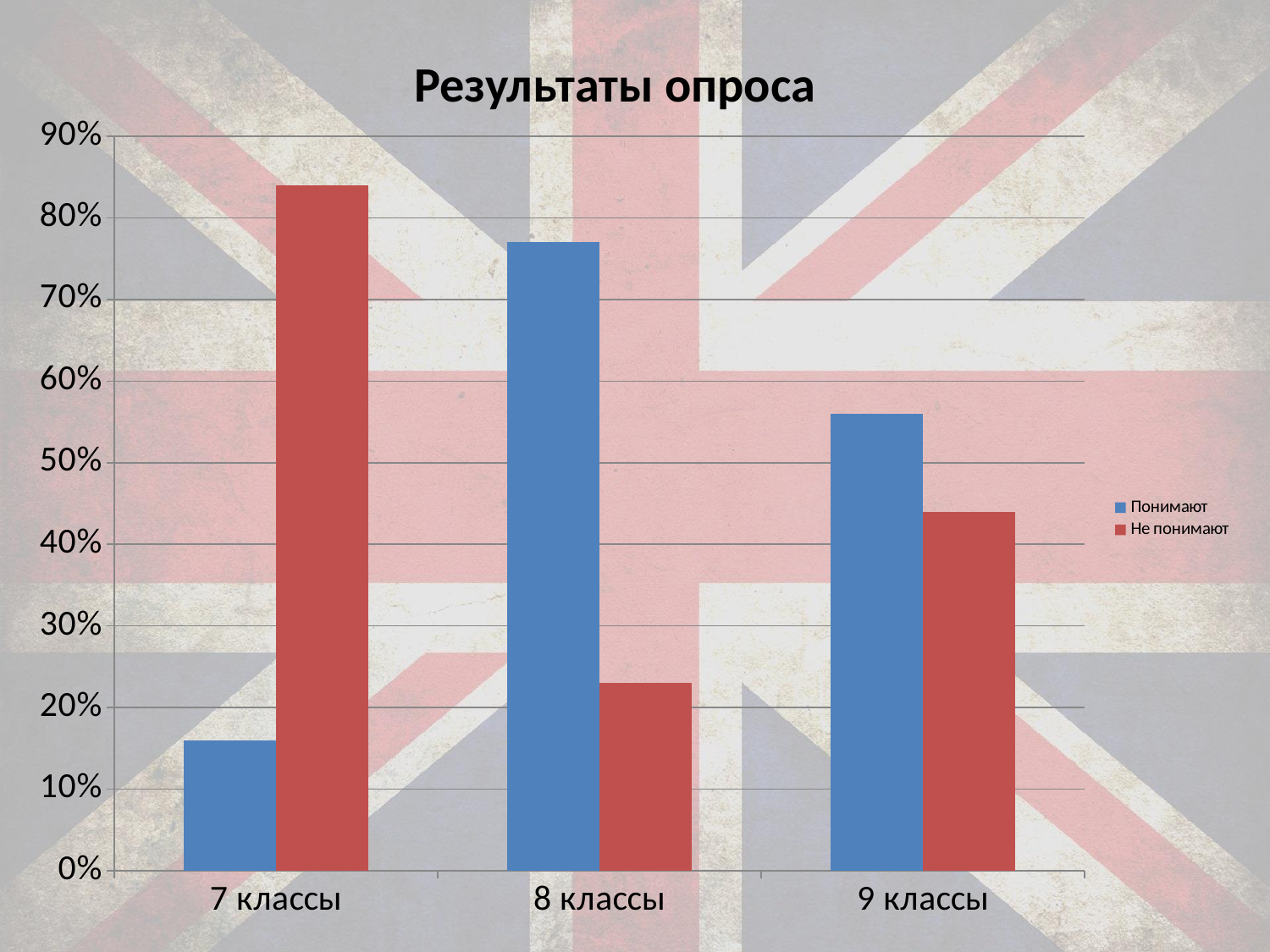
Is the value for Не понимают in 7 классы greater or less than 80%? greater Which category has the lowest value for Не понимают? 8 классы For 9 классы, which is larger: Понимают or Не понимают? Понимают What is the title of the chart? Результаты опроса Which category has the lowest value for Понимают? 7 классы Is the value for Понимают in 7 классы greater or less than 20%? less Which category has the highest value for Не понимают? 7 классы Is the value for Понимают in 8 классы greater or less than 70%? greater How many series does the legend list? 2 What kind of chart is shown on the slide? bar chart Which category has the highest value for Понимают? 8 классы How many categories are shown on the x axis? 3